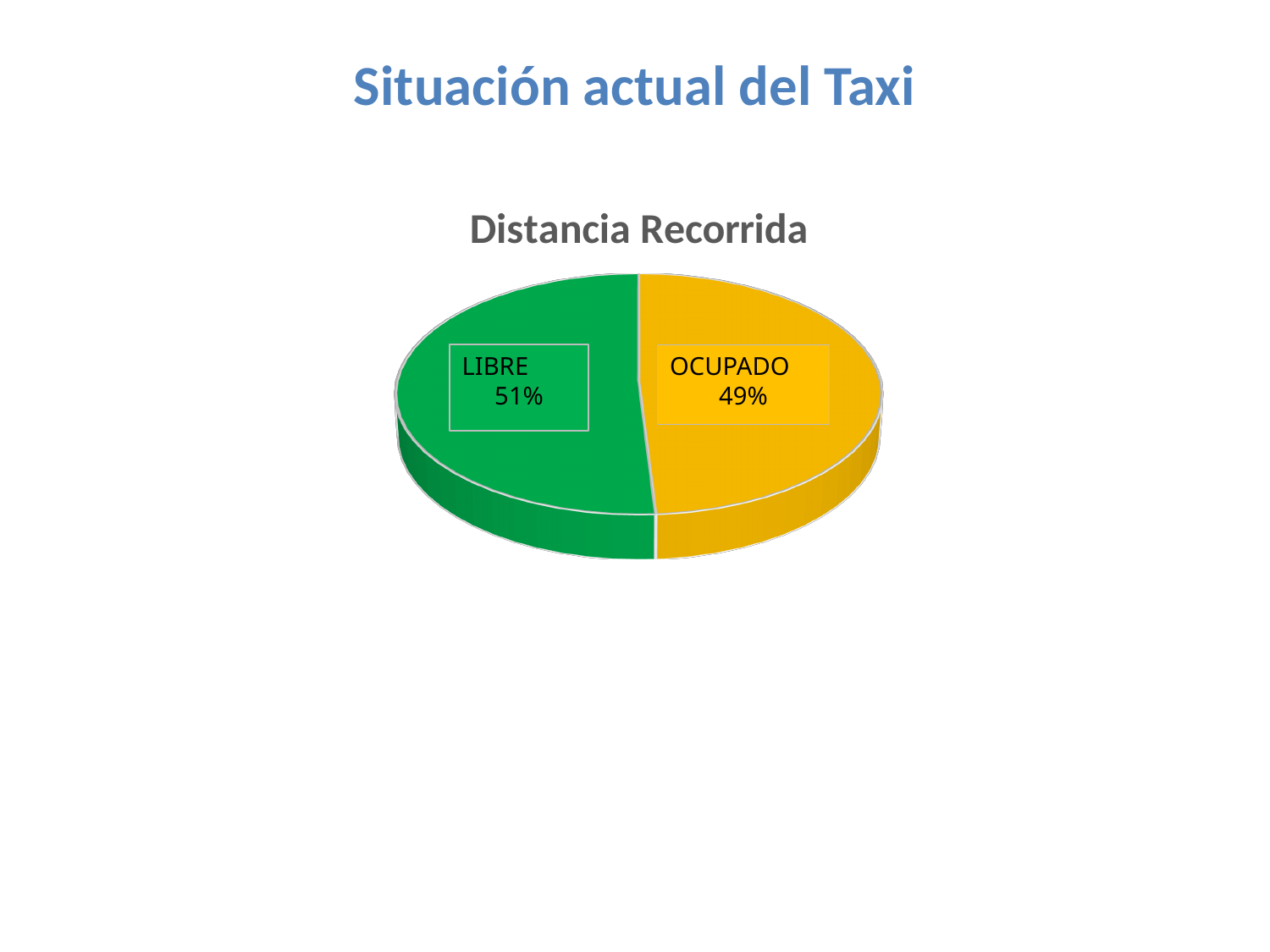
What colour is the OCUPADO slice? Yellow How many slices does the pie chart have? 2 What share of the pie does OCUPADO represent? 49% Which is larger, LIBRE or OCUPADO? LIBRE What is the difference in percentage points between LIBRE and OCUPADO? 2% What kind of chart is shown on the slide? Pie chart What share of the pie does LIBRE represent? 51% Which slice is the smallest in the pie chart? OCUPADO Which slice is the largest in the pie chart? LIBRE Is the value for LIBRE greater or less than 50%? greater What is the title of the chart? Distancia Recorrida Is the value for OCUPADO greater or less than 50%? less